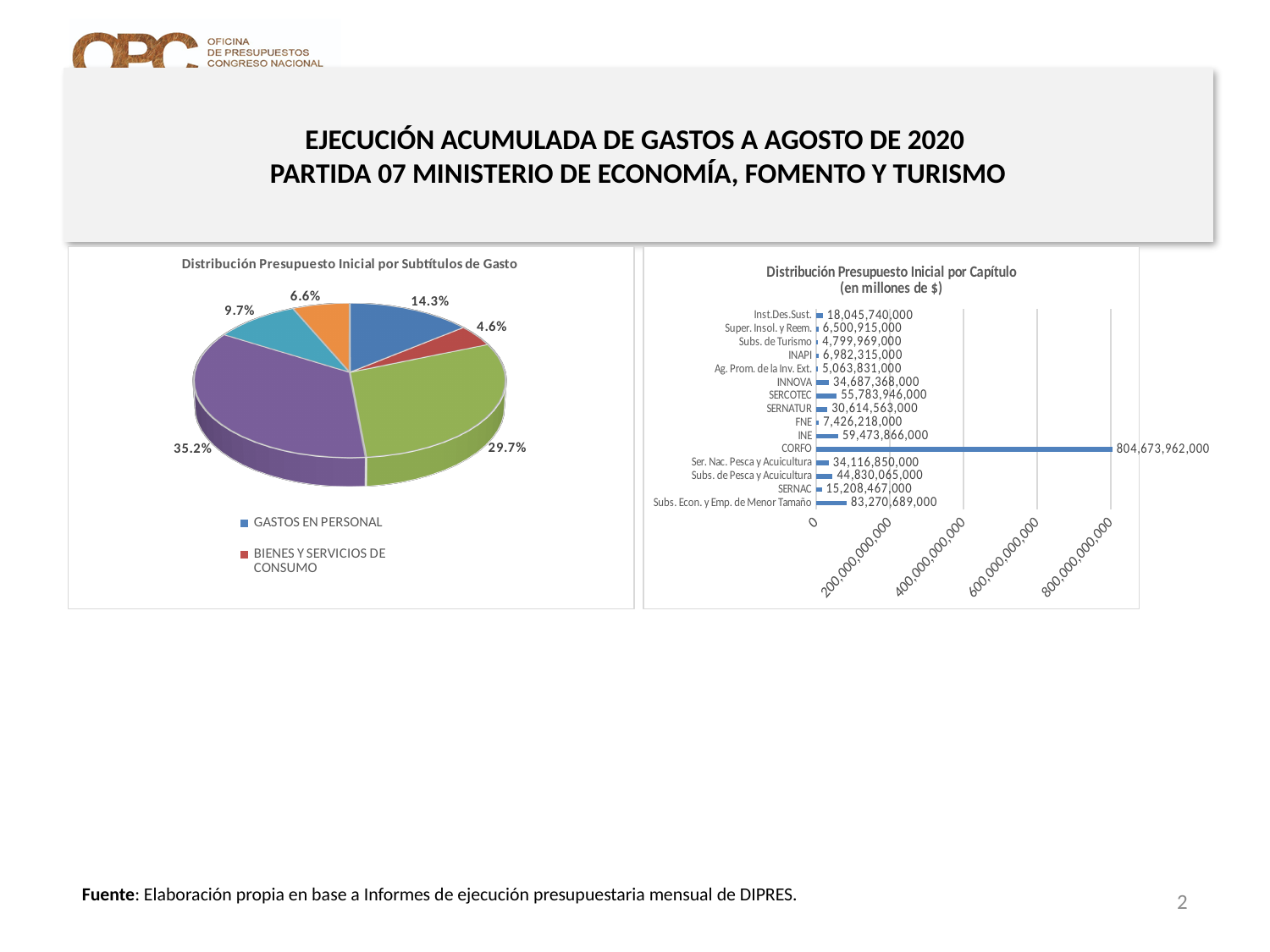
In the pie chart 'Distribución Presupuesto Inicial por Subtítulos de Gasto', what share does GASTOS EN PERSONAL have? 14.3% In the bar chart 'Distribución Presupuesto Inicial por Capítulo', which is larger, INE or INNOVA? INE In the bar chart 'Distribución Presupuesto Inicial por Capítulo', how many capítulos are shown? 15 In the pie chart 'Distribución Presupuesto Inicial por Subtítulos de Gasto', what share does BIENES Y SERVICIOS DE CONSUMO have? 4.6% In the bar chart 'Distribución Presupuesto Inicial por Capítulo', what is the value for SERCOTEC? 55,783,946,000 In the bar chart 'Distribución Presupuesto Inicial por Capítulo', which capítulo has the lowest value? Subs. de Turismo What kind of chart is 'Distribución Presupuesto Inicial por Capítulo'? Bar chart In the bar chart 'Distribución Presupuesto Inicial por Capítulo', which capítulo has the highest value? CORFO In the bar chart 'Distribución Presupuesto Inicial por Capítulo', what is the value for CORFO? 804,673,962,000 In the pie chart 'Distribución Presupuesto Inicial por Subtítulos de Gasto', what is the largest percentage shown? 35.2% In the bar chart 'Distribución Presupuesto Inicial por Capítulo', what is the value for Subs. de Turismo? 4,799,969,000 In the bar chart 'Distribución Presupuesto Inicial por Capítulo', what is the difference between Subs. de Pesca y Acuicultura and Ser. Nac. Pesca y Acuicultura? 10,713,215,000